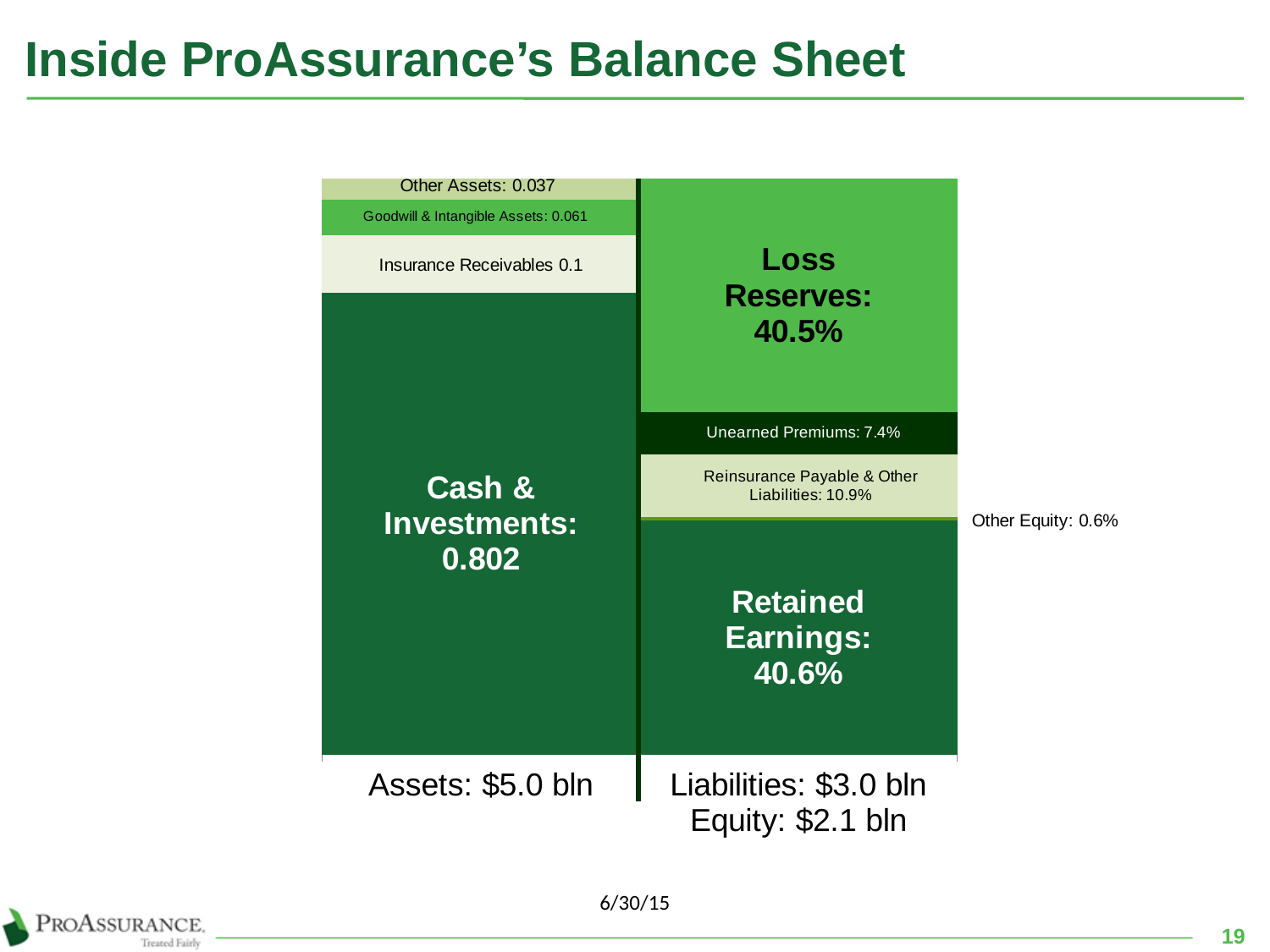
In the Liabilities and Equity bar, what is the share for Reinsurance Payable & Other Liabilities? 10.9% In the Assets bar, what is the value for Cash & Investments? 0.802 In the Assets bar, which segment is the smallest? Other Assets How many segments make up the Assets bar? 4 What total is printed below the Assets bar? Assets: $5.0 bln In the Liabilities and Equity bar, what is the difference between Loss Reserves and Unearned Premiums? 33.1% In the Liabilities and Equity bar, which is larger: Retained Earnings or Loss Reserves? Retained Earnings In the Assets bar, which segment is the largest? Cash & Investments In the Assets bar, what is the value for Goodwill & Intangible Assets? 0.061 In the Liabilities and Equity bar, what is the share for Loss Reserves? 40.5% In the Liabilities and Equity bar, what is the share for Other Equity? 0.6% What kind of chart is shown on the slide? Stacked bar chart